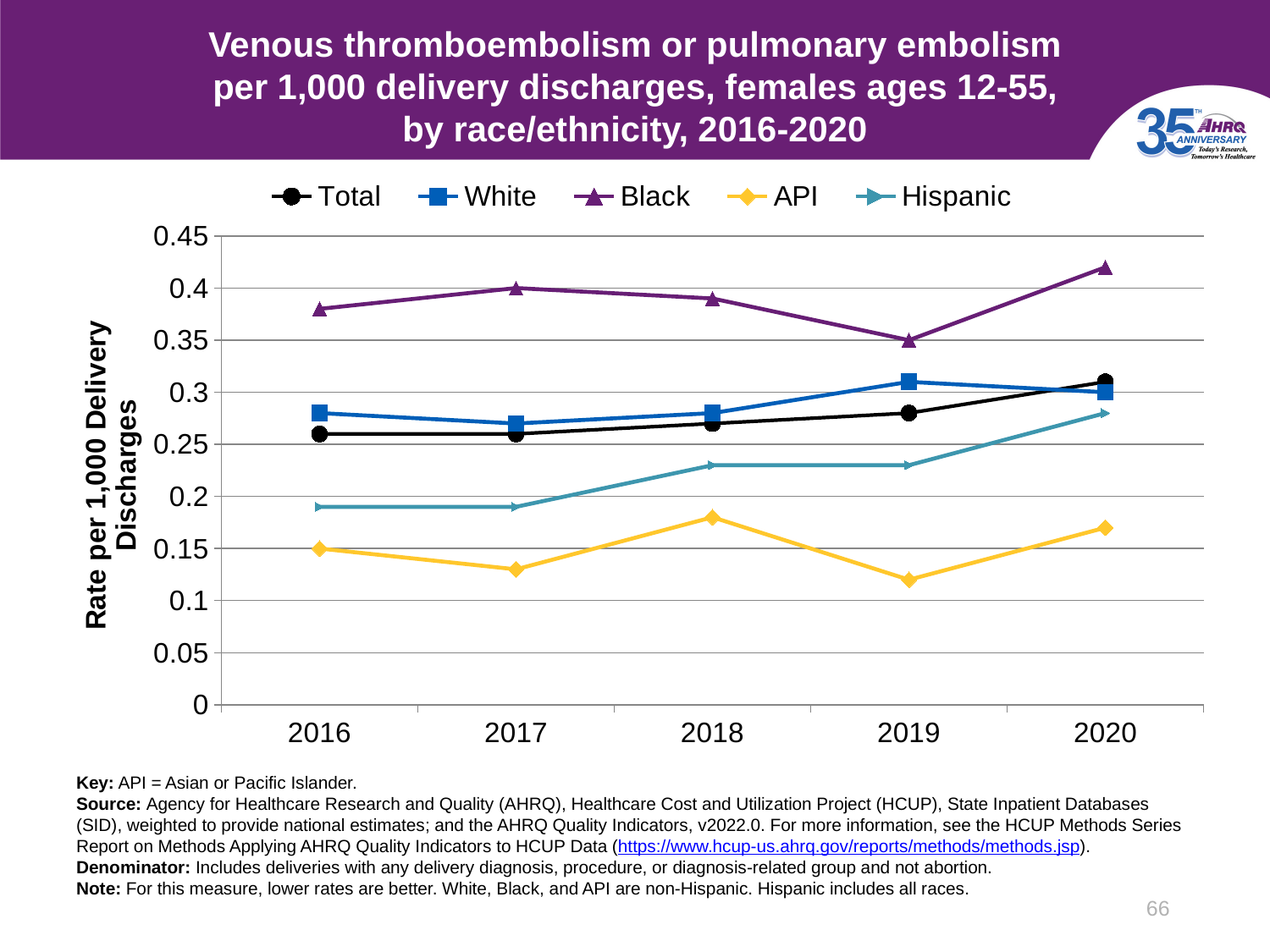
How many years are plotted along the x axis? 5 What is the rate for Black in 2017? 0.4 What is the label on the y axis? Rate per 1,000 Delivery Discharges What kind of chart is shown on the slide? line chart Which race/ethnicity group has the highest rate in 2020? Black Is the value for API in 2019 greater or less than 0.15? less Is the value for Black in 2020 greater or less than 0.4? greater How many series does the legend list? 5 Does the Hispanic rate rise or fall from 2016 to 2020? rise Which group has the lowest rate in 2019? API Which is larger in 2020, the Hispanic rate or the API rate? Hispanic